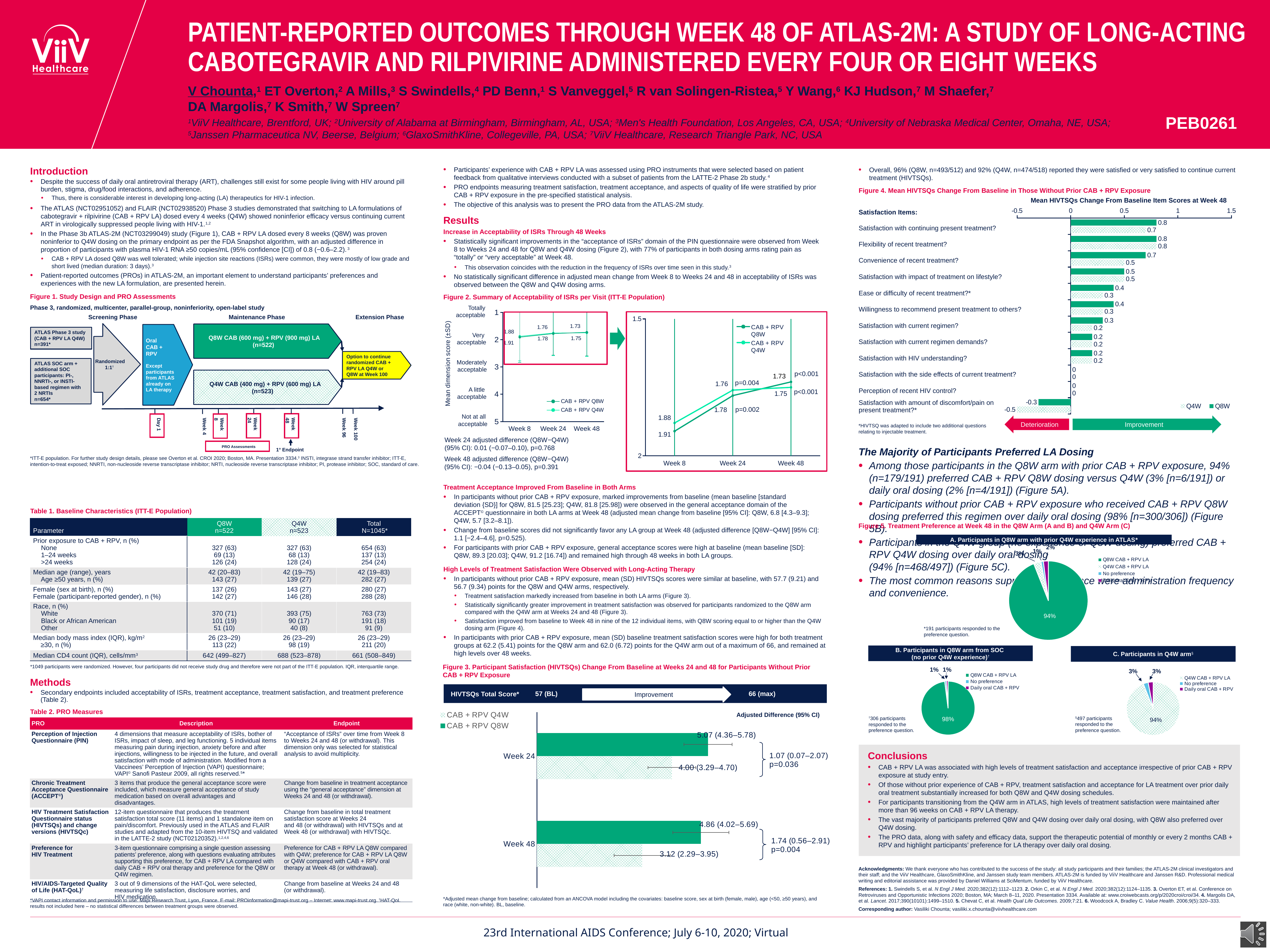
In Figure 2 (Summary of Acceptability of ISRs per Visit), do the CAB + RPV Q8W scores rise or fall from Week 8 to Week 48? fall In Figure 2 (Summary of Acceptability of ISRs per Visit), what is the mean dimension score for CAB + RPV Q8W at Week 8? 1.91 In Figure 2 (Summary of Acceptability of ISRs per Visit), how many series does the legend list? 2 In Figure 2 (Summary of Acceptability of ISRs per Visit), what is the mean dimension score for CAB + RPV Q4W at Week 48? 1.75 In Figure 3 (Participant Satisfaction (HIVTSQs) Change From Baseline), which series has the larger value at Week 48, CAB + RPV Q8W or CAB + RPV Q4W? CAB + RPV Q8W In Figure 4 (Mean HIVTSQs Change From Baseline in Those Without Prior CAB + RPV Exposure), which satisfaction item has the lowest (negative) values for both arms? Satisfaction with amount of discomfort/pain on present treatment What kind of chart is Figure 3 (Participant Satisfaction (HIVTSQs) Change From Baseline at Weeks 24 and 48)? bar chart In Figure 3 (Participant Satisfaction (HIVTSQs) Change From Baseline), what is the value for CAB + RPV Q4W at Week 48? 3.12 (2.29–3.95) In Figure 4 (Mean HIVTSQs Change From Baseline in Those Without Prior CAB + RPV Exposure), how many satisfaction items are plotted? 12 In Figure 5A (Participants in Q8W arm with prior Q4W experience in ATLAS), what share of participants preferred Q8W CAB + RPV LA? 94% In Figure 3 (Participant Satisfaction (HIVTSQs) Change From Baseline), what is the value for CAB + RPV Q8W at Week 24? 5.07 (4.36–5.78) In Figure 5B (Participants in Q8W arm from SOC), what share of participants preferred Q8W CAB + RPV LA? 98%